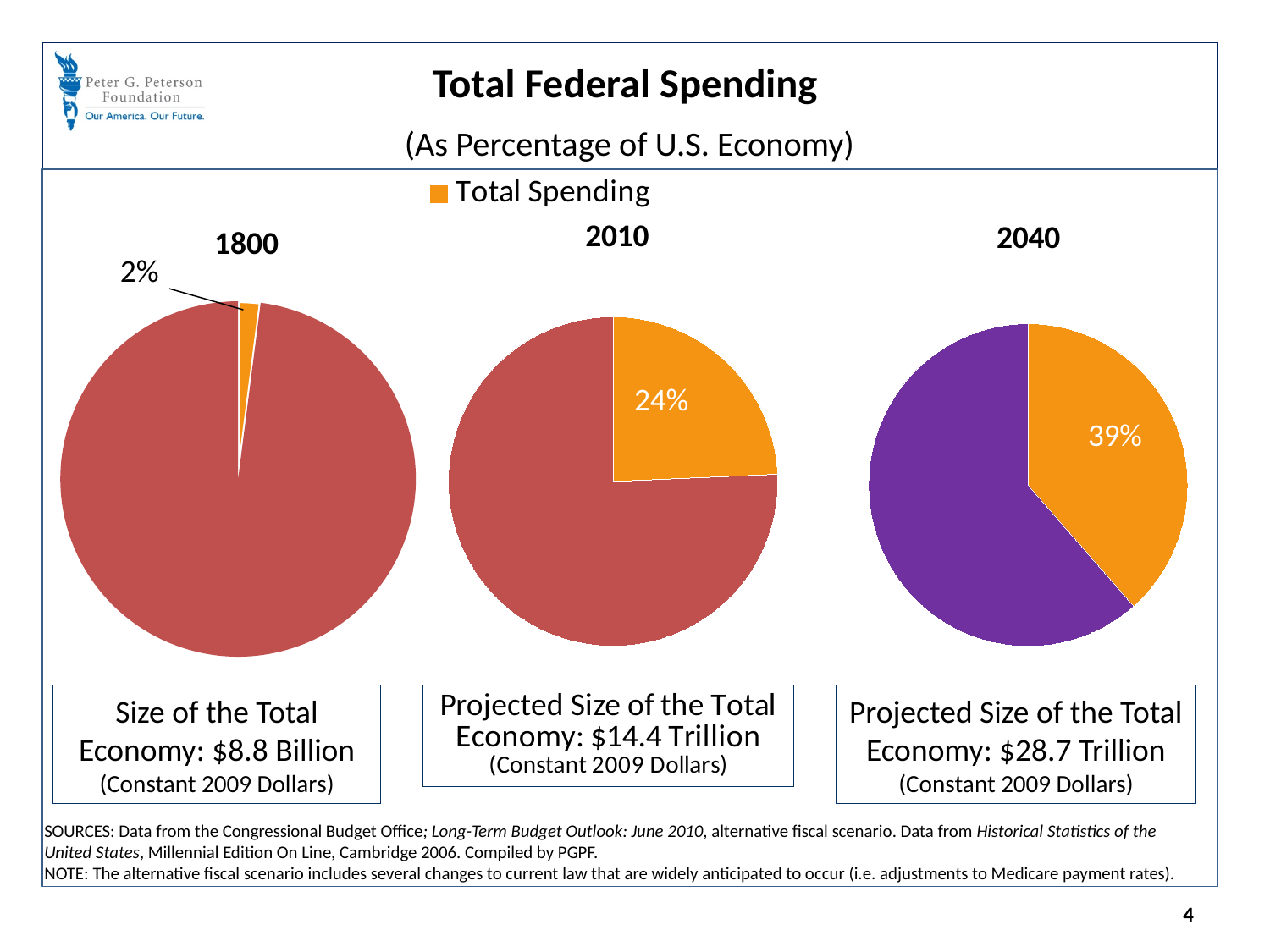
What is the title of the chart on the slide? Total Federal Spending (As Percentage of U.S. Economy) Which year's pie chart shows the smallest Total Spending share? 1800 How many entries does the legend list? 1 In the 2040 pie chart, what percentage of the U.S. economy is Total Spending? 39% In the 1800 pie chart, what percentage of the U.S. economy is Total Spending? 2% What kind of charts are shown on the slide? Pie charts By how many percentage points does the Total Spending share in the 2040 pie chart exceed that in the 2010 pie chart? 15 percentage points By how many percentage points does the Total Spending share in the 2010 pie chart exceed that in the 1800 pie chart? 22 percentage points In the 2010 pie chart, what percentage of the U.S. economy is Total Spending? 24% Which year's pie chart shows the largest Total Spending share? 2040 Is the Total Spending share larger in the 2010 pie chart or the 2040 pie chart? 2040 Does the Total Spending share rise or fall from the 1800 pie chart to the 2040 pie chart? Rise